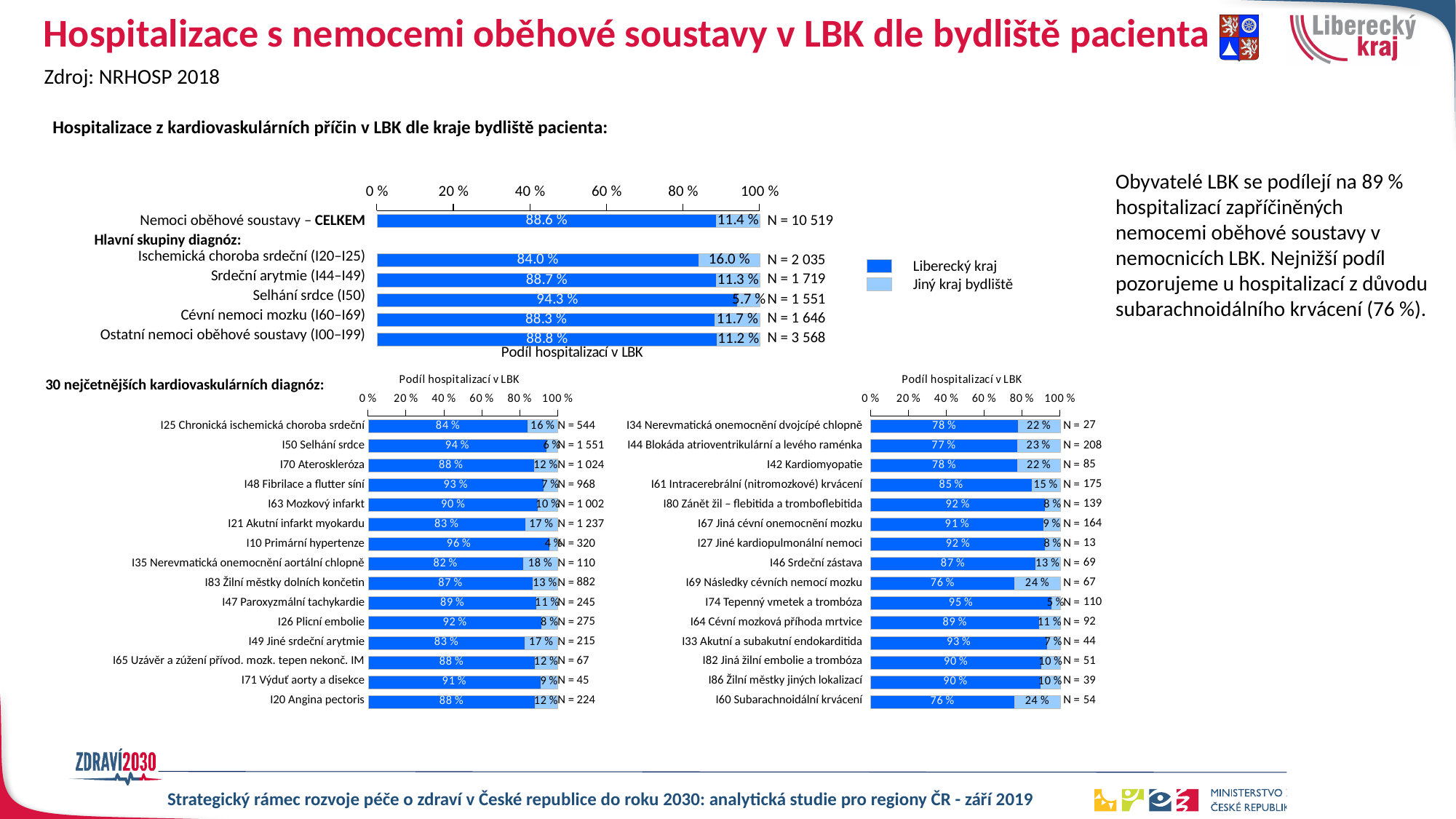
In the top chart, how many series does the legend list? 2 In the bottom-right chart, what is the Jiný kraj bydliště share for I60 Subarachnoidální krvácení? 24 % In the bottom-right chart, which diagnosis has the highest Liberecký kraj share? I74 Tepenný vmetek a trombóza In the bottom-right chart, what is the difference between the Liberecký kraj shares of I74 Tepenný vmetek a trombóza and I44 Blokáda atrioventrikulární a levého raménka? 18 % In the bottom-left chart, which diagnosis has the lowest Liberecký kraj share? I35 Nerevmatická onemocnění aortální chlopně In the top chart, which diagnosis group has the highest Liberecký kraj share? Selhání srdce (I50) What type of chart is the top chart? Stacked bar chart In the bottom-left chart, how many diagnoses are listed? 15 In the top chart, what is the N value shown for Nemoci oběhové soustavy – CELKEM? N = 10 519 In the top chart, what is the Jiný kraj bydliště share for Ischemická choroba srdeční (I20–I25)? 16.0 % In the top chart (Hospitalizace z kardiovaskulárních příčin v LBK dle kraje bydliště pacienta), what is the Liberecký kraj share for Selhání srdce (I50)? 94.3 % In the bottom-left chart (30 nejčetnějších kardiovaskulárních diagnóz), what is the Liberecký kraj share for I10 Primární hypertenze? 96 %